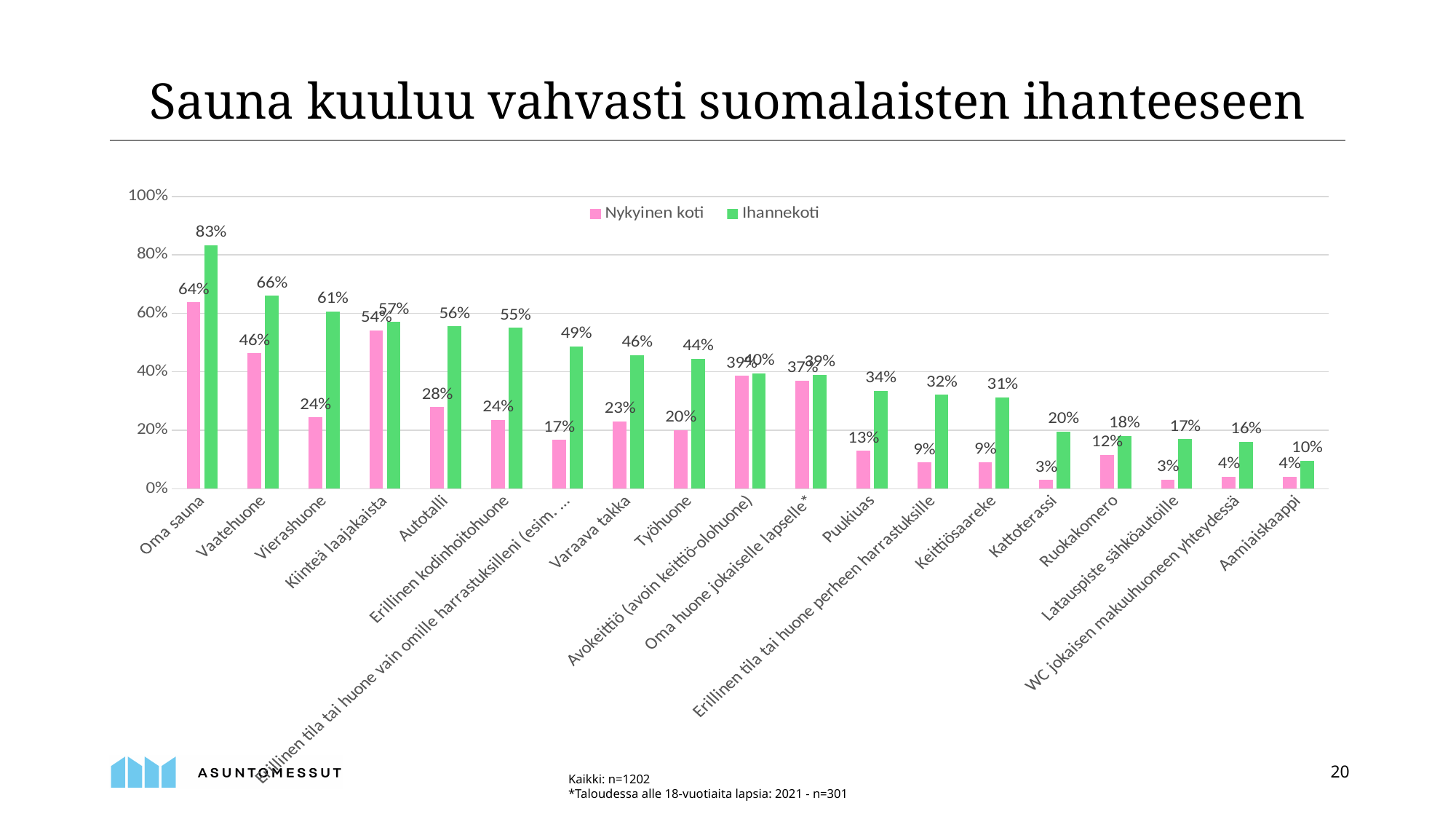
Which series is shown in green? Ihannekoti What is the Nykyinen koti value for Vierashuone? 24% How many series does the legend list? 2 What is the Ihannekoti value for Oma sauna? 83% What is the difference between the Ihannekoti and Nykyinen koti values for Vierashuone? 37% What kind of chart is shown on the slide? Bar chart Which category has the lowest Ihannekoti value? Aamiaiskaappi What is the Ihannekoti value for Puukiuas? 34% Which category has the highest Ihannekoti value? Oma sauna What is the Nykyinen koti value for Kattoterassi? 3% How many categories are shown on the x axis? 19 Which is larger: the Nykyinen koti value for Vaatehuone or the Nykyinen koti value for Autotalli? Vaatehuone